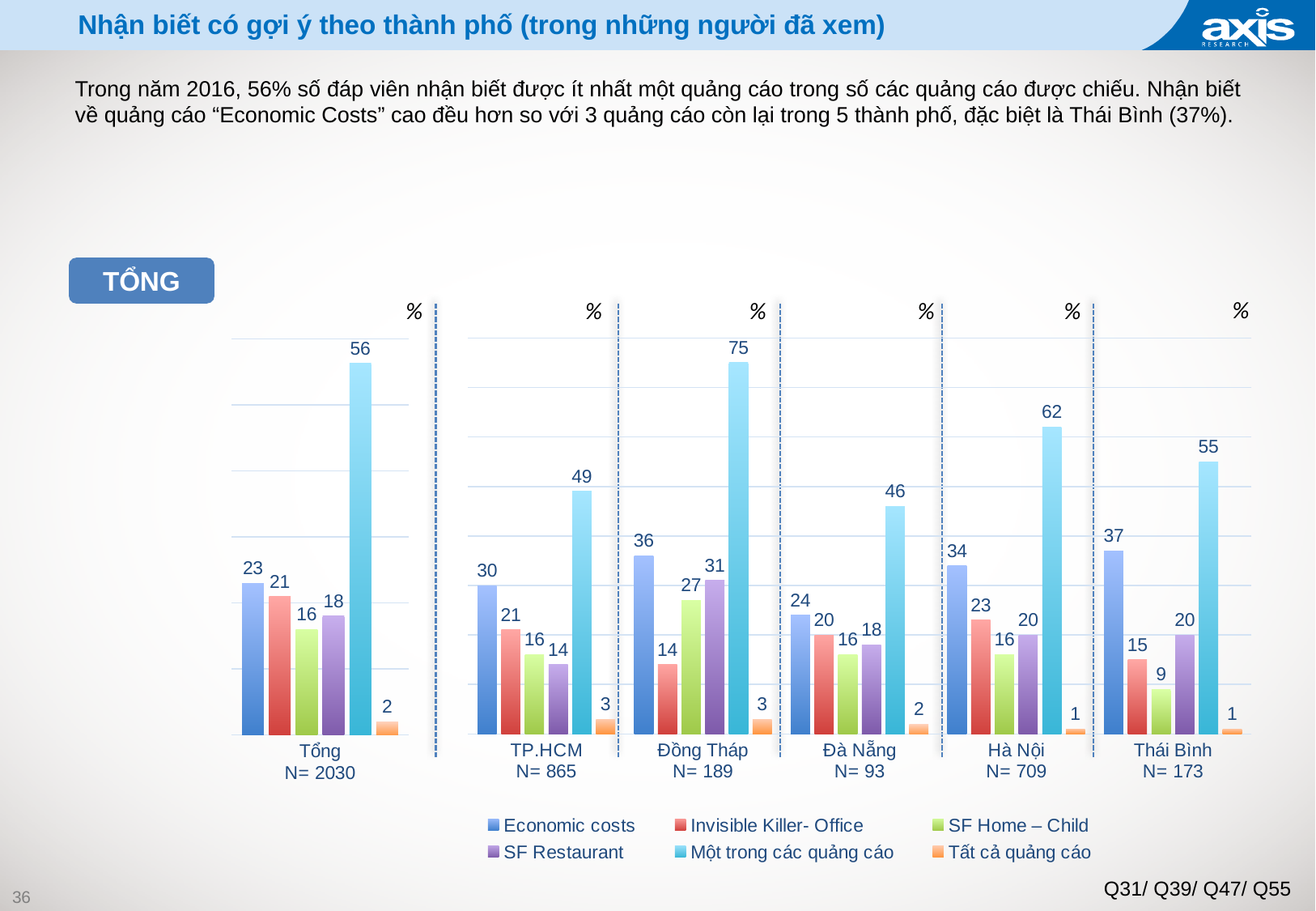
How many city/group categories are shown on the x axis? 6 What kind of chart is shown on the slide? Bar chart What is the value for Một trong các quảng cáo in Đồng Tháp? 75 How many series does the legend list? 6 What is the value for Economic costs in Thái Bình? 37 What is the value for Tất cả quảng cáo in Tổng? 2 What is the sample size (N) shown for Hà Nội? 709 What is the value for SF Restaurant in TP.HCM? 14 What is the difference between Economic costs and Invisible Killer- Office in Hà Nội? 11 Which city has the lowest value for SF Home – Child? Thái Bình Which city has the highest value for Một trong các quảng cáo? Đồng Tháp Which is larger in Đà Nẵng: Economic costs or SF Restaurant? Economic costs